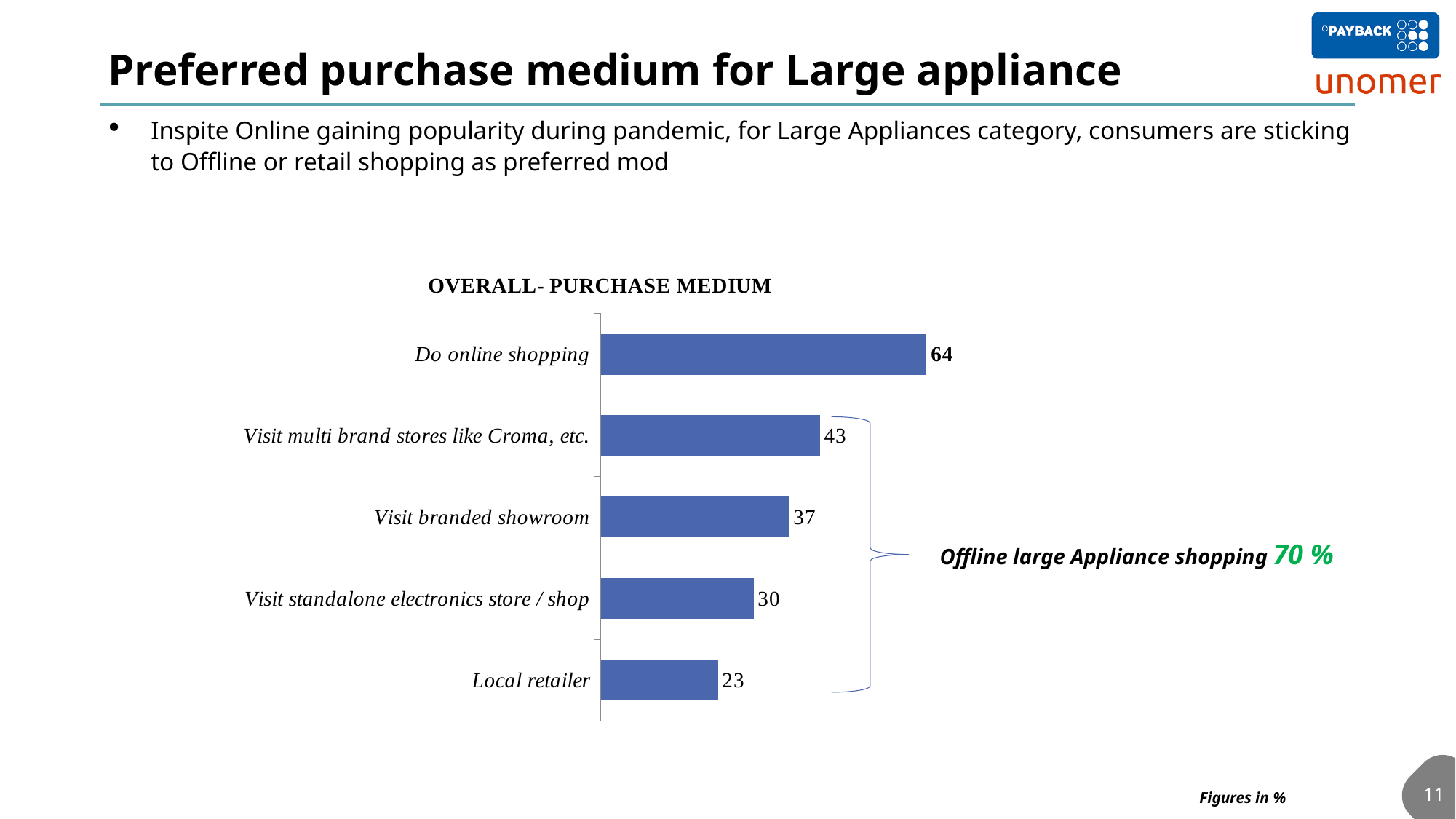
What is the value for Visit branded showroom? 37 What is the value for Visit standalone electronics store / shop? 30 What is the value for Do online shopping? 64 Which is larger, the value for Visit branded showroom or Visit standalone electronics store / shop? Visit branded showroom What is the value for Visit multi brand stores like Croma, etc.? 43 What is the difference between the values for Do online shopping and Local retailer? 41 Which category has the lowest value? Local retailer What is the value for Local retailer? 23 What is the title of the chart? OVERALL- PURCHASE MEDIUM Which category has the highest value? Do online shopping How many categories are shown in the chart? 5 What kind of chart is shown on the slide? Bar chart